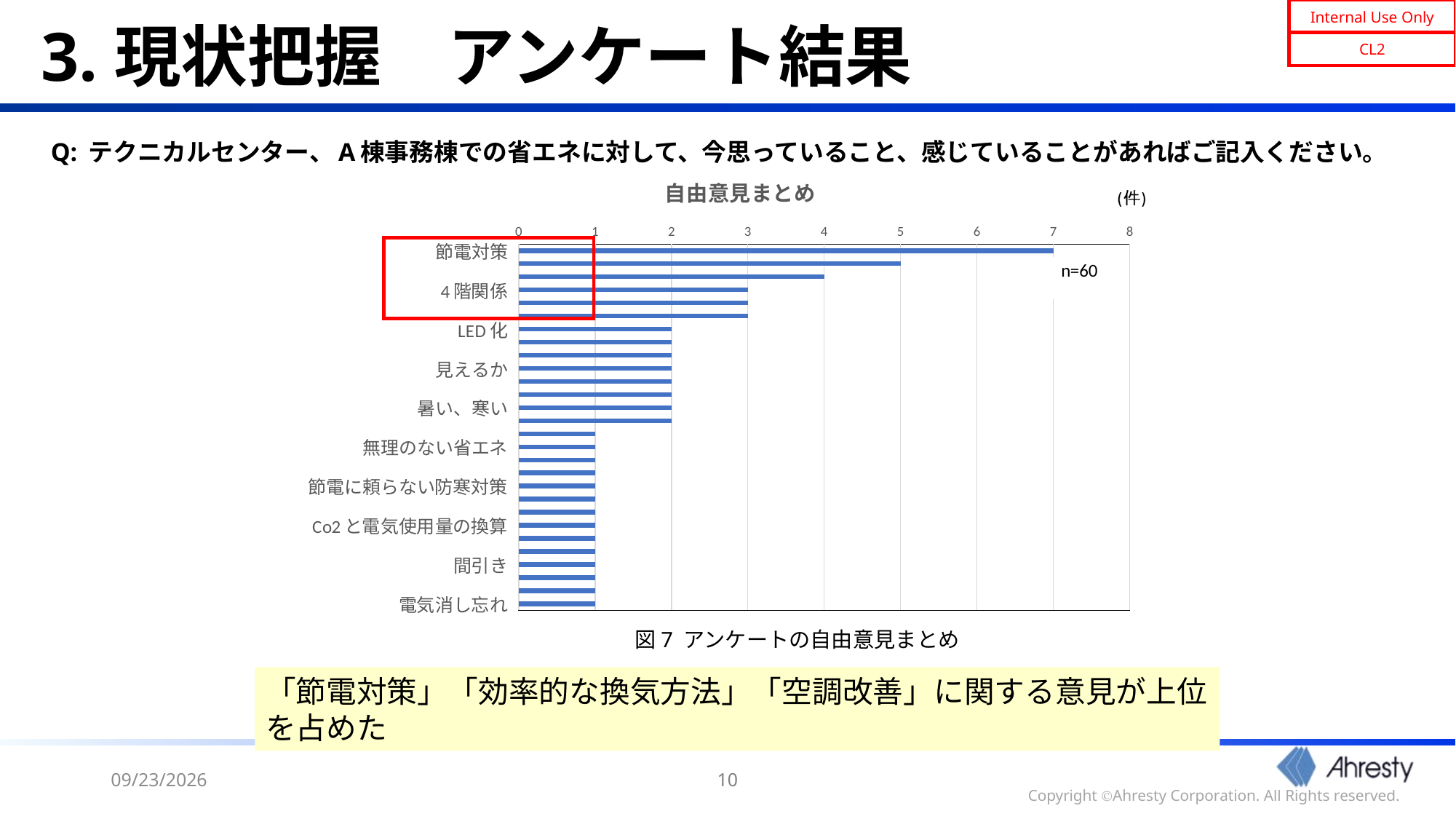
What sample size (n) is noted on the chart? n=60 What is the value for LED化? 2 What is the value for 節電対策? 7 What is the value for 電気消し忘れ? 1 What is the difference between the values for 節電対策 and 4階関係? 4 Which category has the highest value? 節電対策 What type of chart is shown on the slide? bar chart What is the title of the chart? 自由意見まとめ Is the value for 間引き greater or less than 2? less What is the value for 4階関係? 3 Which is larger, the value for 節電対策 or the value for LED化? 節電対策 Is the value for 節電対策 greater or less than 5? greater